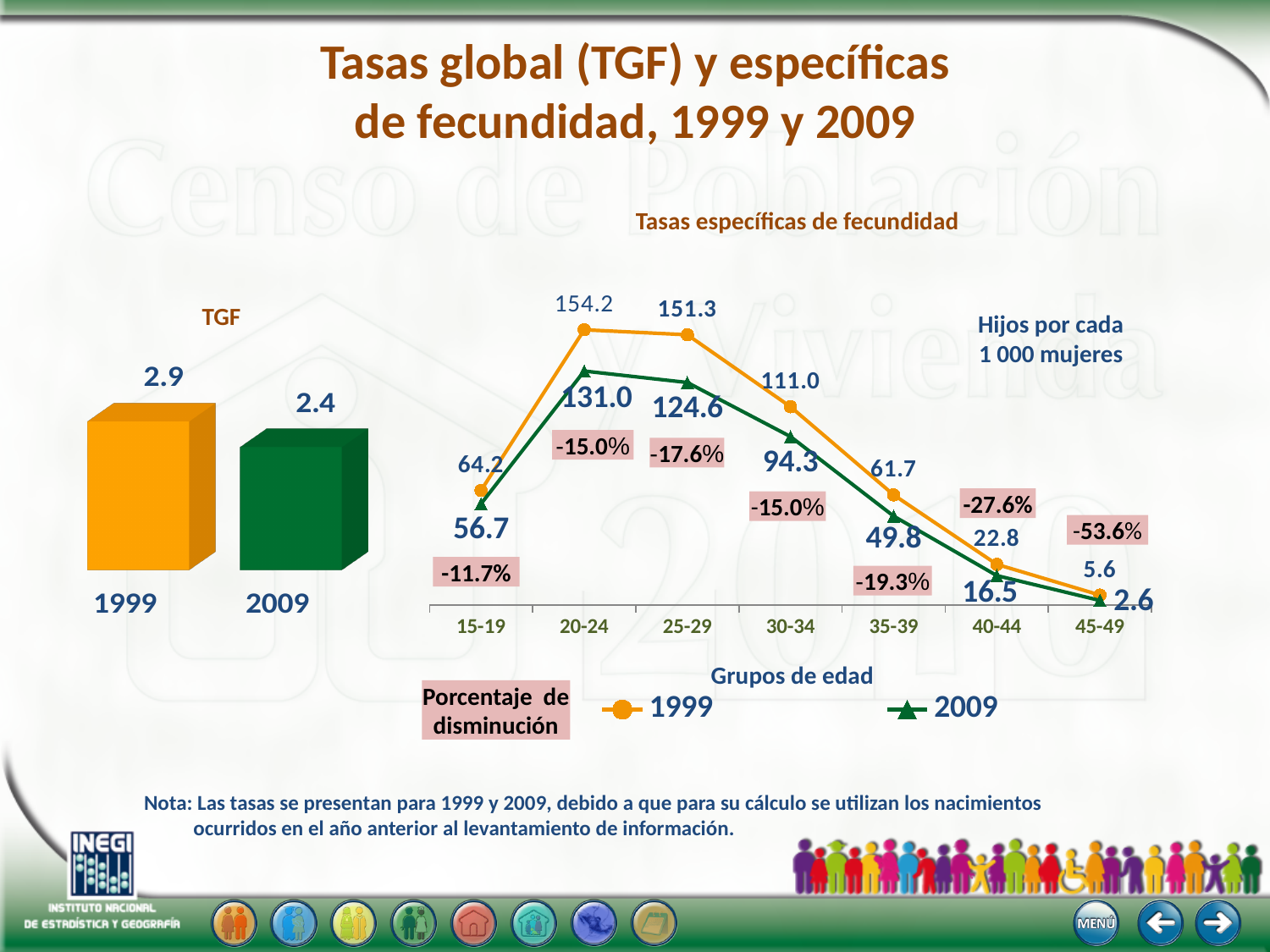
In the TGF bar chart, what is the value for 2009? 2.4 What kind of chart is the TGF chart on the left? bar chart In the 'Tasas específicas de fecundidad' chart, what is the 2009 value for the 30-34 age group? 94.3 In the 'Tasas específicas de fecundidad' chart, how many age groups are shown on the x axis? 7 In the 'Tasas específicas de fecundidad' chart, which age group has the lowest 1999 value? 45-49 In the 'Tasas específicas de fecundidad' chart, what is the difference between the 1999 and 2009 values for the 25-29 age group? 26.7 In the 'Tasas específicas de fecundidad' chart, what is the 1999 value for the 20-24 age group? 154.2 In the TGF bar chart, what is the value for 1999? 2.9 In the 'Tasas específicas de fecundidad' chart, which age group has the highest 2009 value? 20-24 In the 'Tasas específicas de fecundidad' chart, what percentage decrease is shown for the 45-49 age group? -53.6% In the 'Tasas específicas de fecundidad' chart, how many series does the legend list? 2 In the TGF bar chart, what is the difference between the 1999 and 2009 values? 0.5